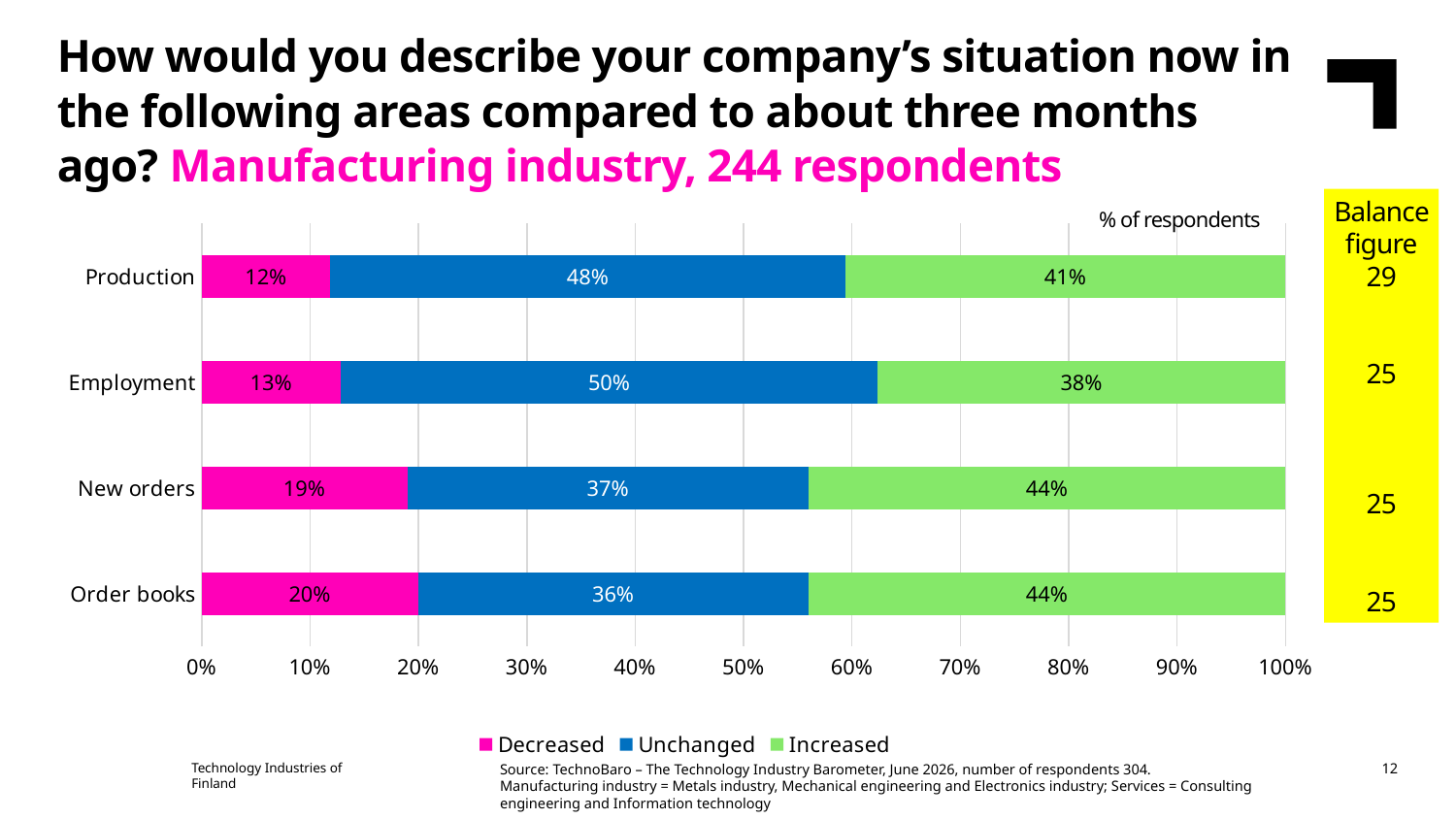
What percentage of respondents reported that Order books Decreased? 20% How many categories are shown on the y axis of the chart? 4 What percentage of respondents reported that Production was Unchanged? 48% What is the difference between the Unchanged share for Employment and the Unchanged share for Order books? 14% What is the Balance figure shown for Production? 29 What kind of chart is shown on the slide? Stacked bar chart Which category has the highest share of respondents reporting Decreased? Order books What percentage of respondents reported that New orders Increased? 44% Which series is shown in blue in the legend? Unchanged Which is larger: the Increased share for Production or the Increased share for Employment? Production Which category has the lowest share of respondents reporting Increased? Employment How many series does the legend list? 3